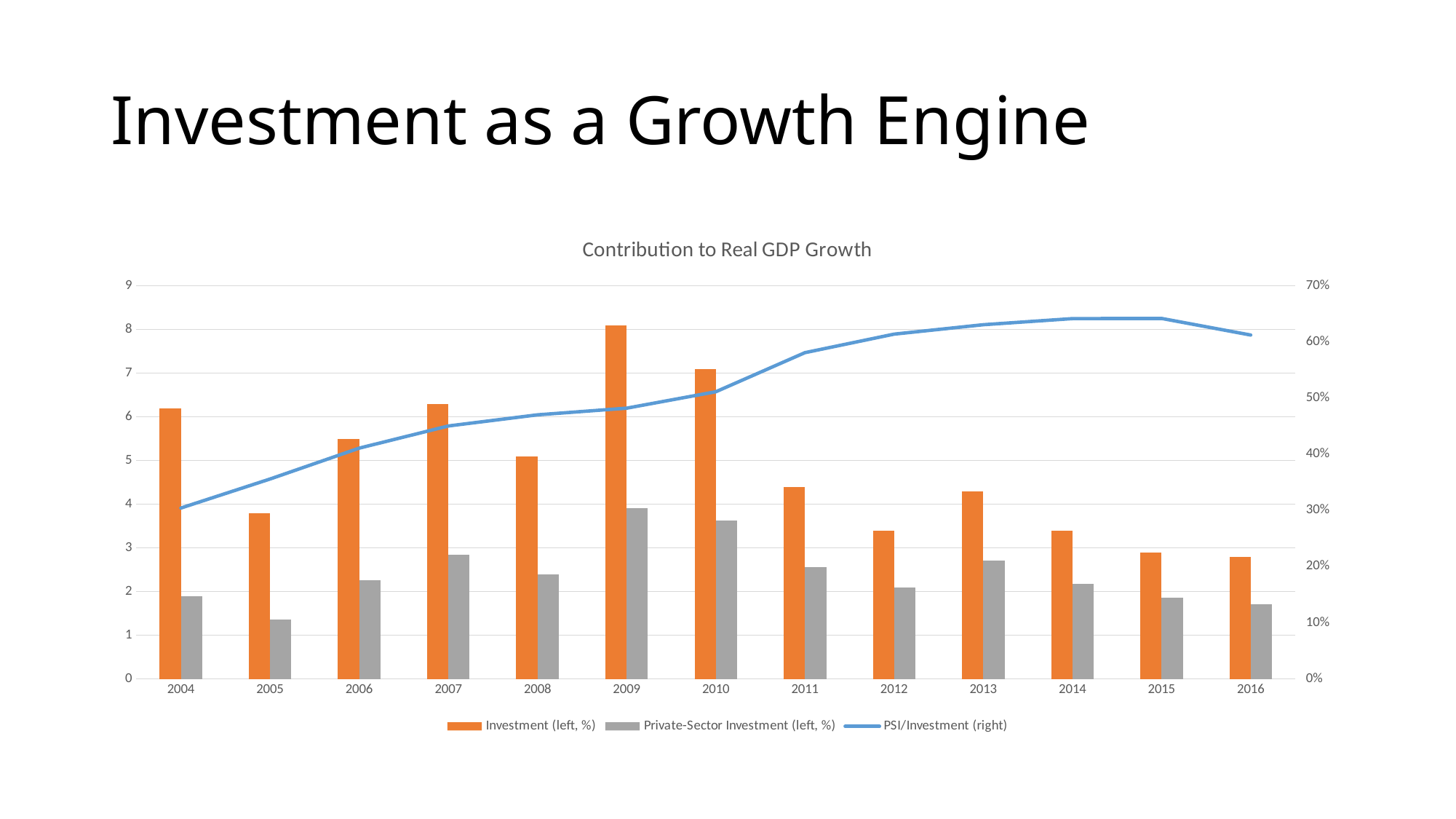
What kind of chart is this? Combined bar and line chart Which is larger, the Investment (left, %) bar for 2004 or for 2005? 2004 Is the PSI/Investment (right) value for 2014 greater or less than 60%? greater How many years are shown on the x axis? 13 Is the PSI/Investment (right) value for 2004 greater or less than 40%? less In which year is the Private-Sector Investment (left, %) bar lowest? 2005 How many series does the legend list? 3 What is the title of the chart? Contribution to Real GDP Growth Is the Investment (left, %) value for 2009 greater or less than 7? greater Does the PSI/Investment (right) line generally rise or fall from 2004 to 2015? rise In which year is the Investment (left, %) bar highest? 2009